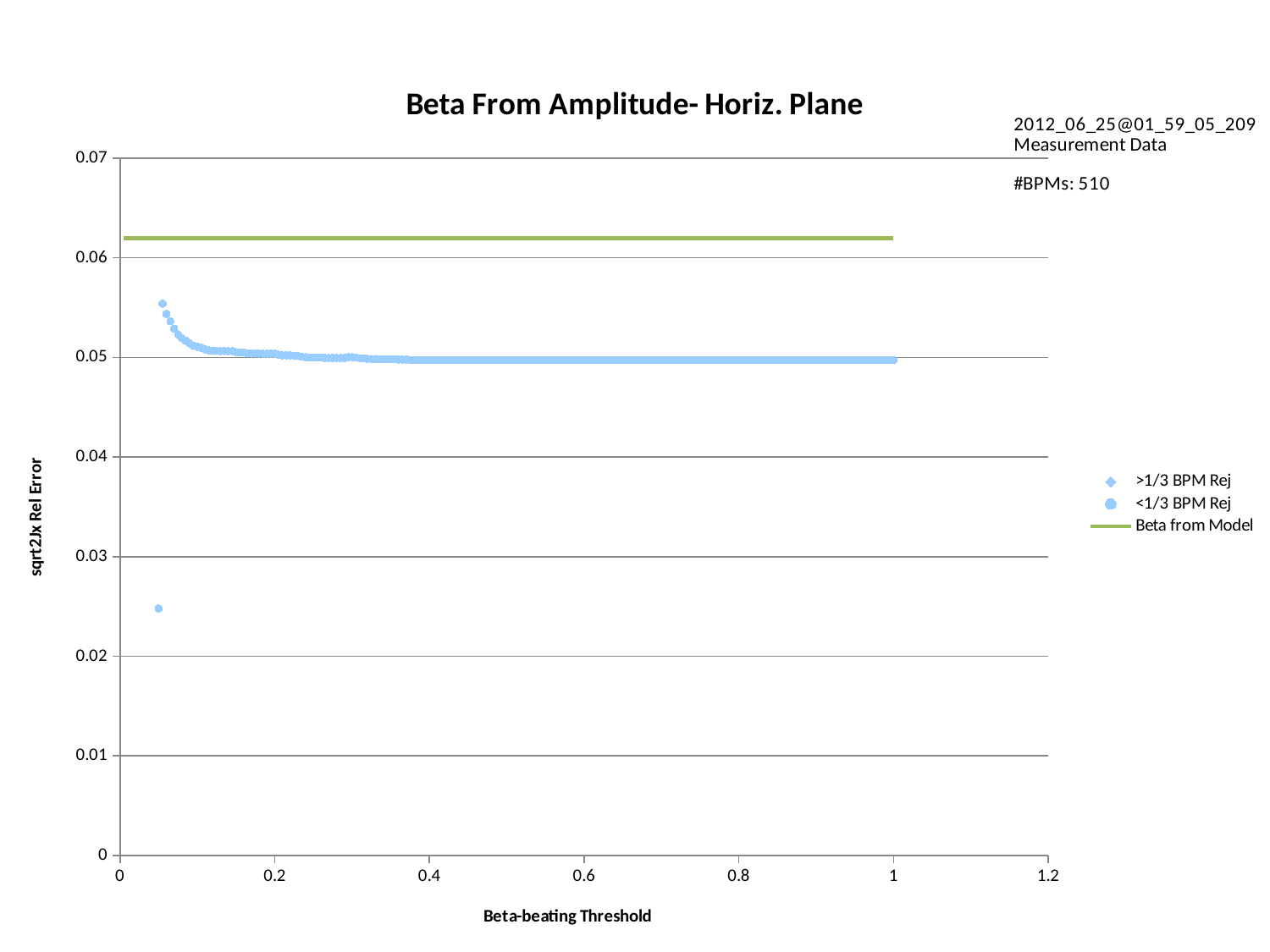
How many series does the legend list? 3 What is the title of the chart? Beta From Amplitude- Horiz. Plane Is the value of the Beta from Model line greater or less than 0.06? greater Do the <1/3 BPM Rej values rise or fall as the Beta-beating Threshold increases from 0.05 to 0.4? fall Is the value of the Beta from Model line greater or less than 0.07? less What kind of chart is shown on the slide? scatter chart Is the highest <1/3 BPM Rej point in the main curve greater or less than 0.05? greater How many BPMs are stated on the slide? 510 What is the label of the x axis? Beta-beating Threshold Which is higher across the plotted range: the Beta from Model line or the <1/3 BPM Rej points? Beta from Model